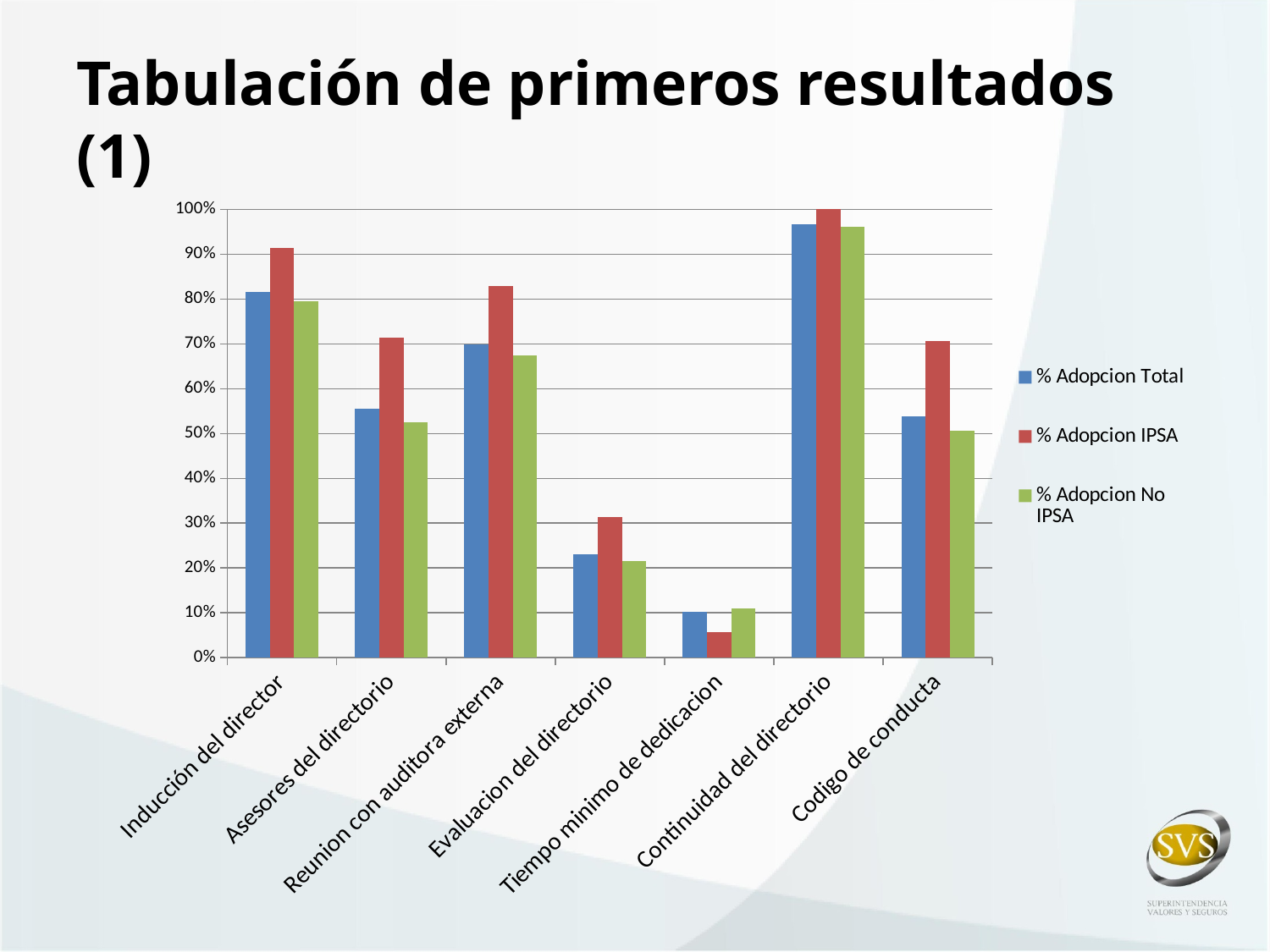
Is the % Adopcion No IPSA value for Reunion con auditora externa greater or less than 60%? greater What is the % Adopcion IPSA value for Continuidad del directorio? 100% How many series does the chart's legend list? 3 Is the % Adopcion IPSA value for Tiempo minimo de dedicacion greater or less than 10%? less Which category has the lowest % Adopcion IPSA value? Tiempo minimo de dedicacion How many categories are shown on the x axis of the chart? 7 Is the % Adopcion Total value for Evaluacion del directorio greater or less than 30%? less What kind of chart is shown on the slide? bar chart For Inducción del director, which is larger: % Adopcion Total or % Adopcion IPSA? % Adopcion IPSA Which category has the highest % Adopcion Total value? Continuidad del directorio What is the title of the slide containing the chart? Tabulación de primeros resultados (1) For Tiempo minimo de dedicacion, which is larger: % Adopcion IPSA or % Adopcion No IPSA? % Adopcion No IPSA